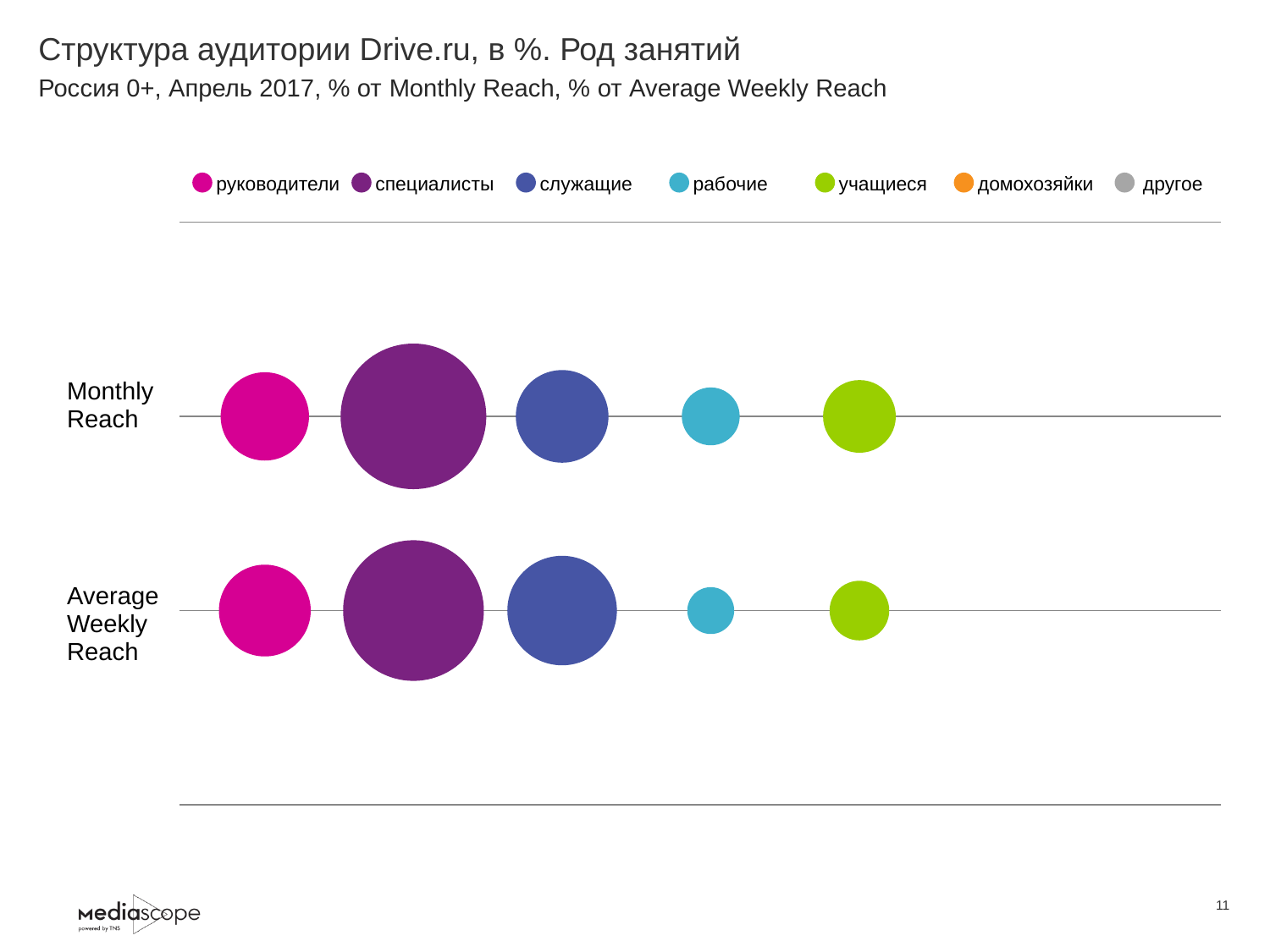
Among the bubbles shown in the Average Weekly Reach row, which occupation group has the smallest bubble? рабочие How many series does the legend list? 7 In the Average Weekly Reach row, which bubble is larger: служащие or учащиеся? служащие Which occupation group has the largest bubble in the Average Weekly Reach row? специалисты What kind of chart is shown on the slide? bubble chart Among the bubbles shown in the Monthly Reach row, which occupation group has the smallest bubble? рабочие Which occupation group has the largest bubble in the Monthly Reach row? специалисты Which legend entry is shown in orange? домохозяйки What is the title of the chart on the slide? Структура аудитории Drive.ru, в %. Род занятий In the Monthly Reach row, which bubble is larger: специалисты or рабочие? специалисты How many rows (categories) are plotted on the chart? 2